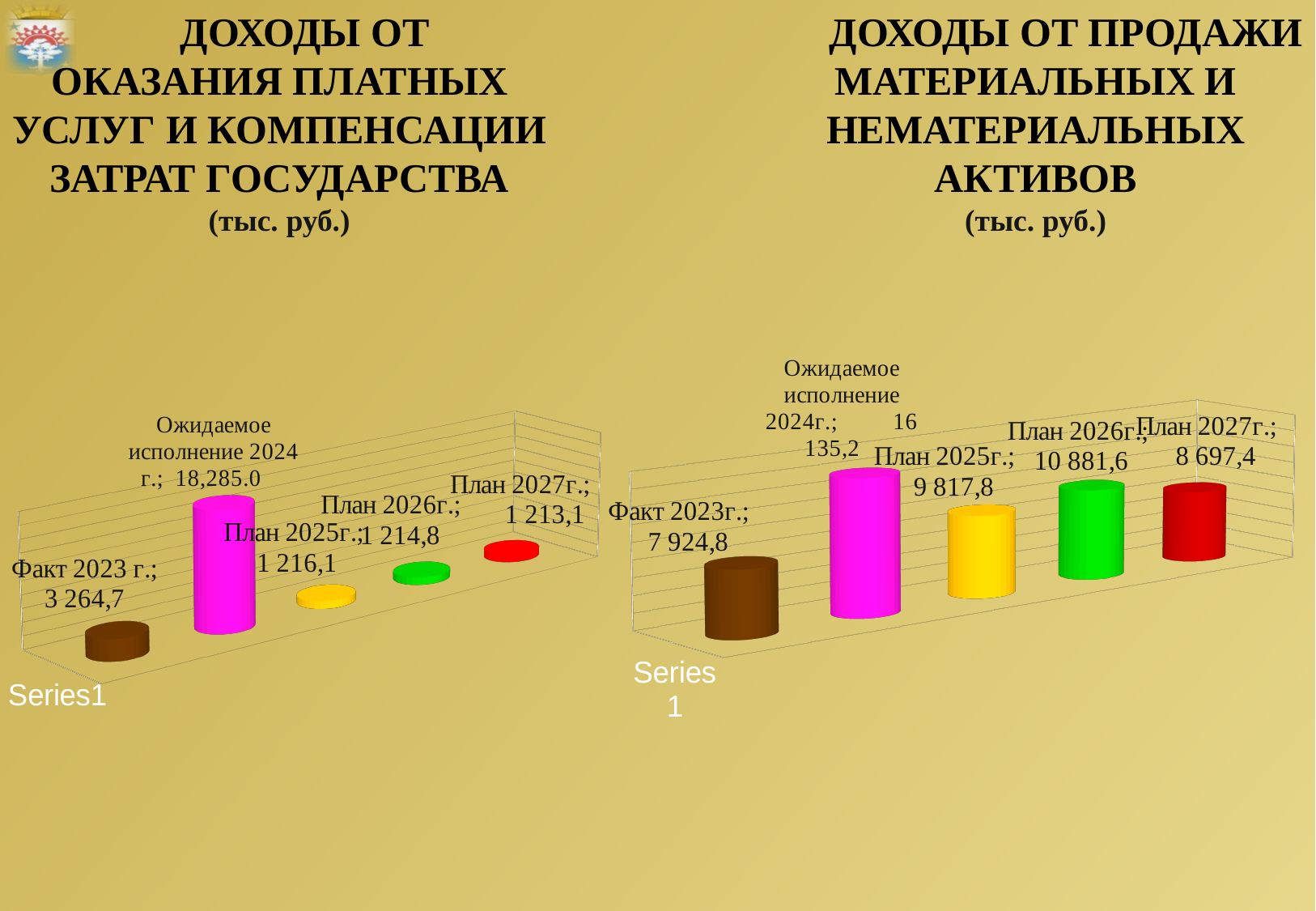
On the right chart (ДОХОДЫ ОТ ПРОДАЖИ МАТЕРИАЛЬНЫХ И НЕМАТЕРИАЛЬНЫХ АКТИВОВ), what is the difference between План 2026г. and План 2025г.? 1 063,8 On the left chart (ДОХОДЫ ОТ ОКАЗАНИЯ ПЛАТНЫХ УСЛУГ), which category has the lowest value? План 2027г. On the right chart (ДОХОДЫ ОТ ПРОДАЖИ МАТЕРИАЛЬНЫХ И НЕМАТЕРИАЛЬНЫХ АКТИВОВ), what is the value for Ожидаемое исполнение 2024г.? 16 135,2 On the right chart (ДОХОДЫ ОТ ПРОДАЖИ МАТЕРИАЛЬНЫХ И НЕМАТЕРИАЛЬНЫХ АКТИВОВ), what is the value for План 2025г.? 9 817,8 On the left chart (ДОХОДЫ ОТ ОКАЗАНИЯ ПЛАТНЫХ УСЛУГ И КОМПЕНСАЦИИ ЗАТРАТ ГОСУДАРСТВА), what is the value for Факт 2023 г.? 3 264,7 What type of chart is the right chart (ДОХОДЫ ОТ ПРОДАЖИ МАТЕРИАЛЬНЫХ И НЕМАТЕРИАЛЬНЫХ АКТИВОВ)? Bar chart On the right chart (ДОХОДЫ ОТ ПРОДАЖИ МАТЕРИАЛЬНЫХ И НЕМАТЕРИАЛЬНЫХ АКТИВОВ), which is larger: План 2026г. or План 2027г.? План 2026г. On the right chart (ДОХОДЫ ОТ ПРОДАЖИ МАТЕРИАЛЬНЫХ И НЕМАТЕРИАЛЬНЫХ АКТИВОВ), which category has the lowest value? Факт 2023г. On the left chart (ДОХОДЫ ОТ ОКАЗАНИЯ ПЛАТНЫХ УСЛУГ), what is the value for План 2026г.? 1 214,8 On the left chart (ДОХОДЫ ОТ ОКАЗАНИЯ ПЛАТНЫХ УСЛУГ), what is the difference between Факт 2023 г. and План 2025г.? 2 048,6 On the left chart (ДОХОДЫ ОТ ОКАЗАНИЯ ПЛАТНЫХ УСЛУГ), which category has the highest value? Ожидаемое исполнение 2024 г. On the left chart (ДОХОДЫ ОТ ОКАЗАНИЯ ПЛАТНЫХ УСЛУГ), how many categories are plotted? 5